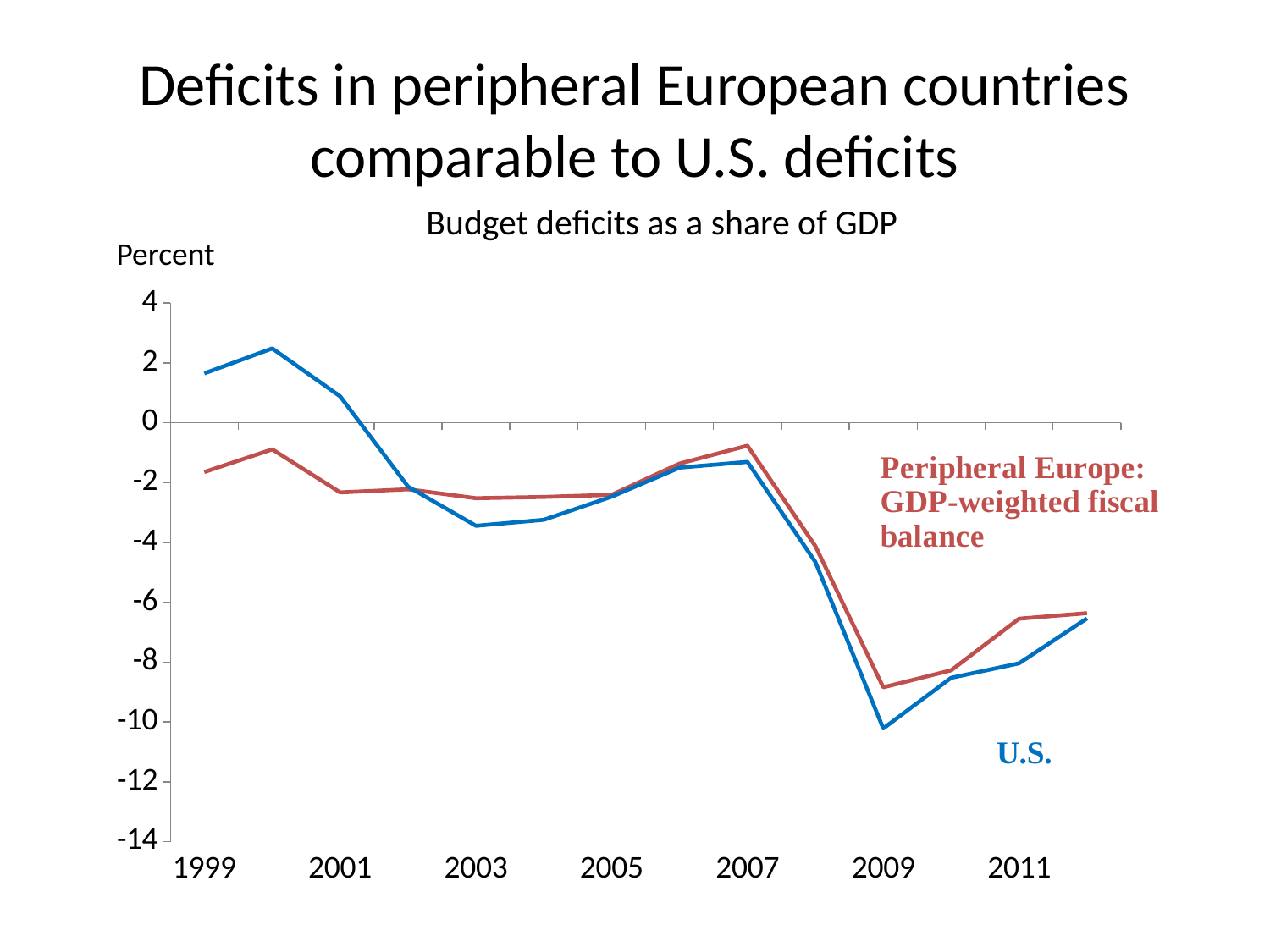
What unit is shown on the vertical axis label? Percent What kind of chart is shown on the slide? line chart In which year does the Peripheral Europe line reach its lowest value? 2009 Is the Peripheral Europe value in 2003 greater or less than -2? less In which year does the U.S. line reach its lowest value? 2009 Does the U.S. line rise or fall between 2007 and 2009? fall In 2009, which series has the higher value, U.S. or Peripheral Europe? Peripheral Europe How many series are plotted on the chart? 2 In 2000, which series has the higher value, U.S. or Peripheral Europe? U.S. Is the U.S. value in 2000 greater or less than 2? greater Is the U.S. value in 2009 greater or less than -8? less What is the subtitle of the chart? Budget deficits as a share of GDP